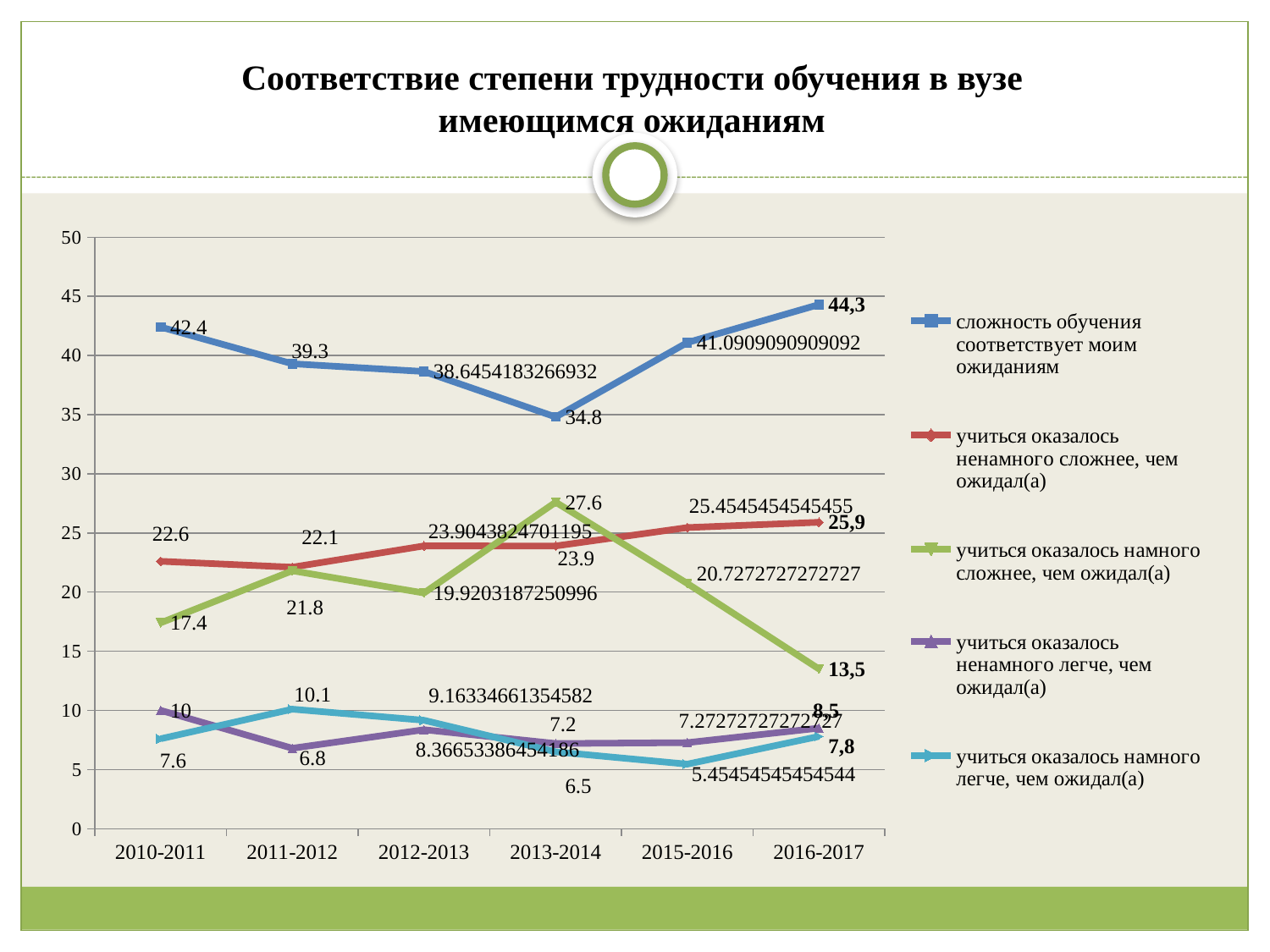
What type of chart is shown on the slide? line chart In which year is the value for 'сложность обучения соответствует моим ожиданиям' lowest? 2013-2014 How many series does the legend list? 5 What is the value for 'учиться оказалось намного сложнее, чем ожидал(а)' in 2013-2014? 27.6 Does the value for 'учиться оказалось ненамного сложнее, чем ожидал(а)' rise or fall from 2011-2012 to 2016-2017? rise What is the value for 'учиться оказалось намного легче, чем ожидал(а)' in 2016-2017? 7,8 Is the value for 'учиться оказалось ненамного сложнее, чем ожидал(а)' in 2015-2016 greater or less than 25? greater How many academic-year categories are shown on the x axis? 6 What is the value for 'сложность обучения соответствует моим ожиданиям' in 2010-2011? 42.4 Which is larger in 2011-2012: 'учиться оказалось ненамного легче, чем ожидал(а)' or 'учиться оказалось намного легче, чем ожидал(а)'? учиться оказалось намного легче, чем ожидал(а) What is the difference between the 2010-2011 and 2011-2012 values for 'сложность обучения соответствует моим ожиданиям'? 3.1 In which year is the value for 'учиться оказалось намного сложнее, чем ожидал(а)' highest? 2013-2014